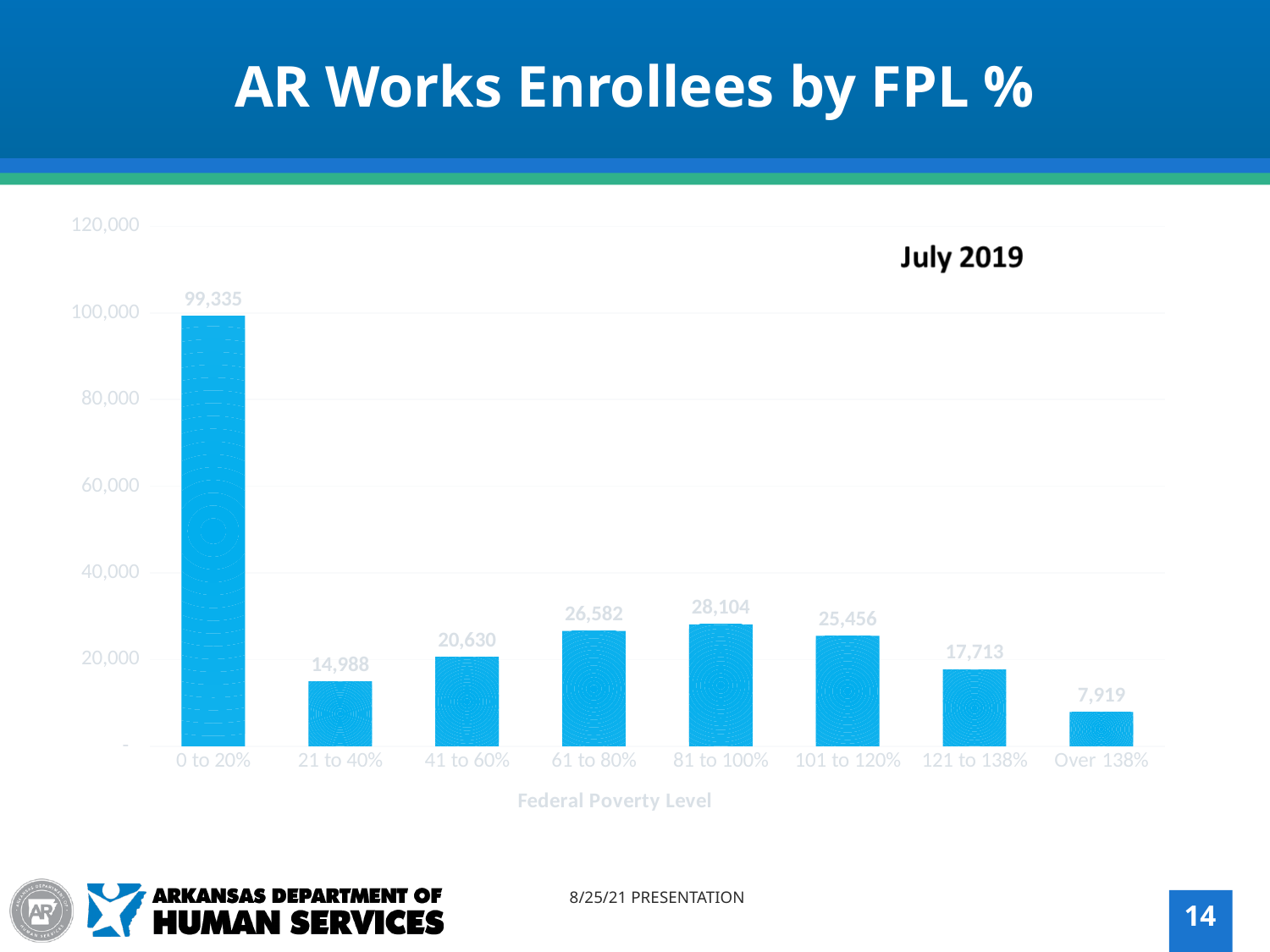
What is the value for the Over 138% FPL category? 7,919 Is the value for 21 to 40% greater or less than 20,000? less Which FPL category has the highest number of enrollees? 0 to 20% What month and year does the chart's data refer to, according to the label on the chart? July 2019 What is the value for the 81 to 100% FPL category? 28,104 Which is larger, the value for 101 to 120% or the value for 121 to 138%? 101 to 120% What is the difference between the 61 to 80% and 41 to 60% categories? 5,952 What kind of chart is shown on the slide? bar chart Which FPL category has the lowest number of enrollees? Over 138% How many FPL categories are shown on the x axis? 8 What is the x-axis title of the chart? Federal Poverty Level What is the number of AR Works enrollees in the 0 to 20% FPL category? 99,335